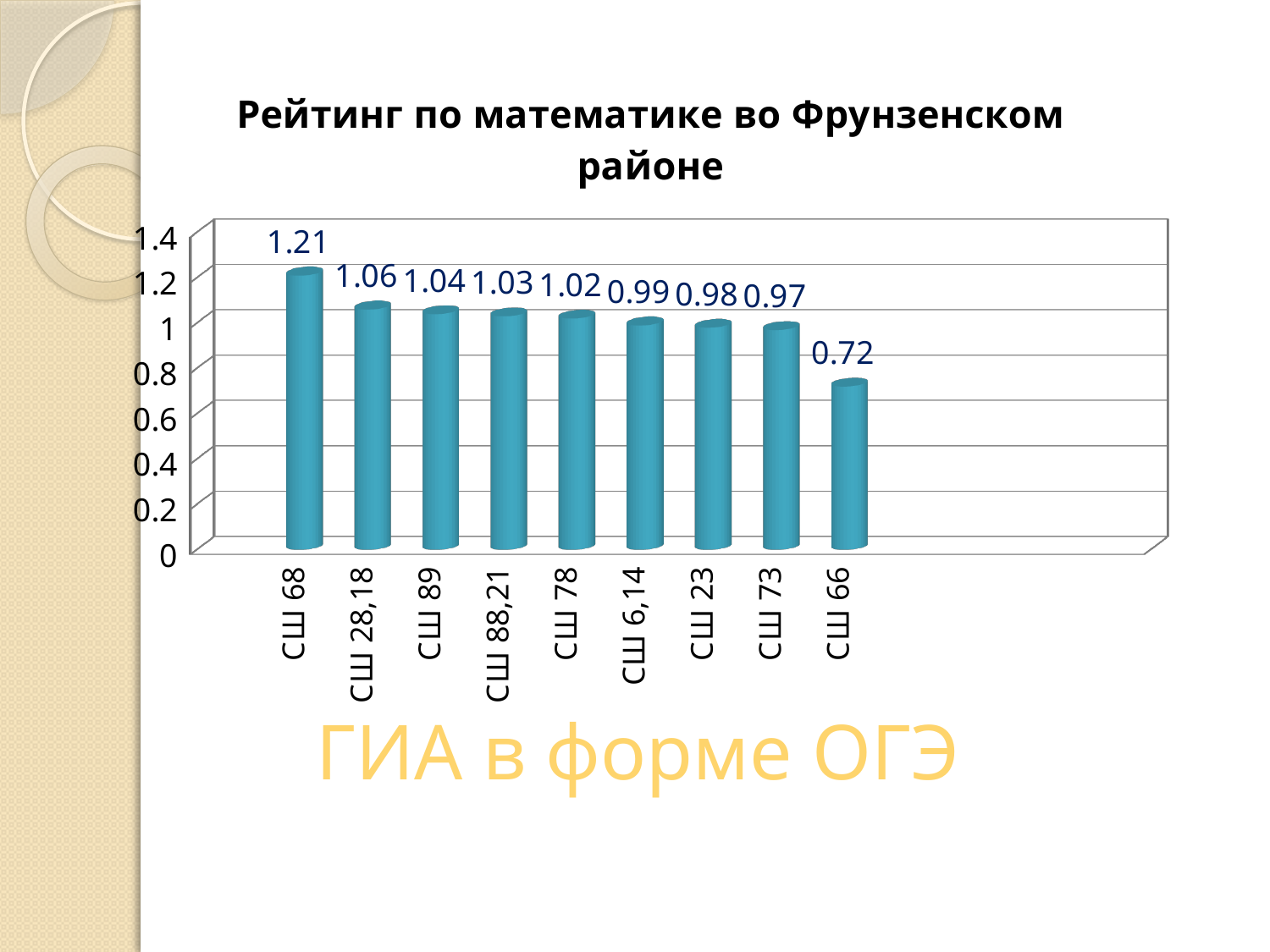
What is the difference between the values for СШ 68 and СШ 66? 0.49 What is the value for СШ 68? 1.21 How many categories are shown on the chart? 9 Which is larger, the value for СШ 28,18 or the value for СШ 73? СШ 28,18 Is the value for СШ 23 greater or less than 1? less Which category has the lowest value? СШ 66 Which category has the highest value? СШ 68 What is the title of the chart? Рейтинг по математике во Фрунзенском районе What is the value for СШ 88,21? 1.03 Do the values rise or fall from left to right along the x axis? fall What kind of chart is shown on the slide? bar chart What is the value for СШ 66? 0.72